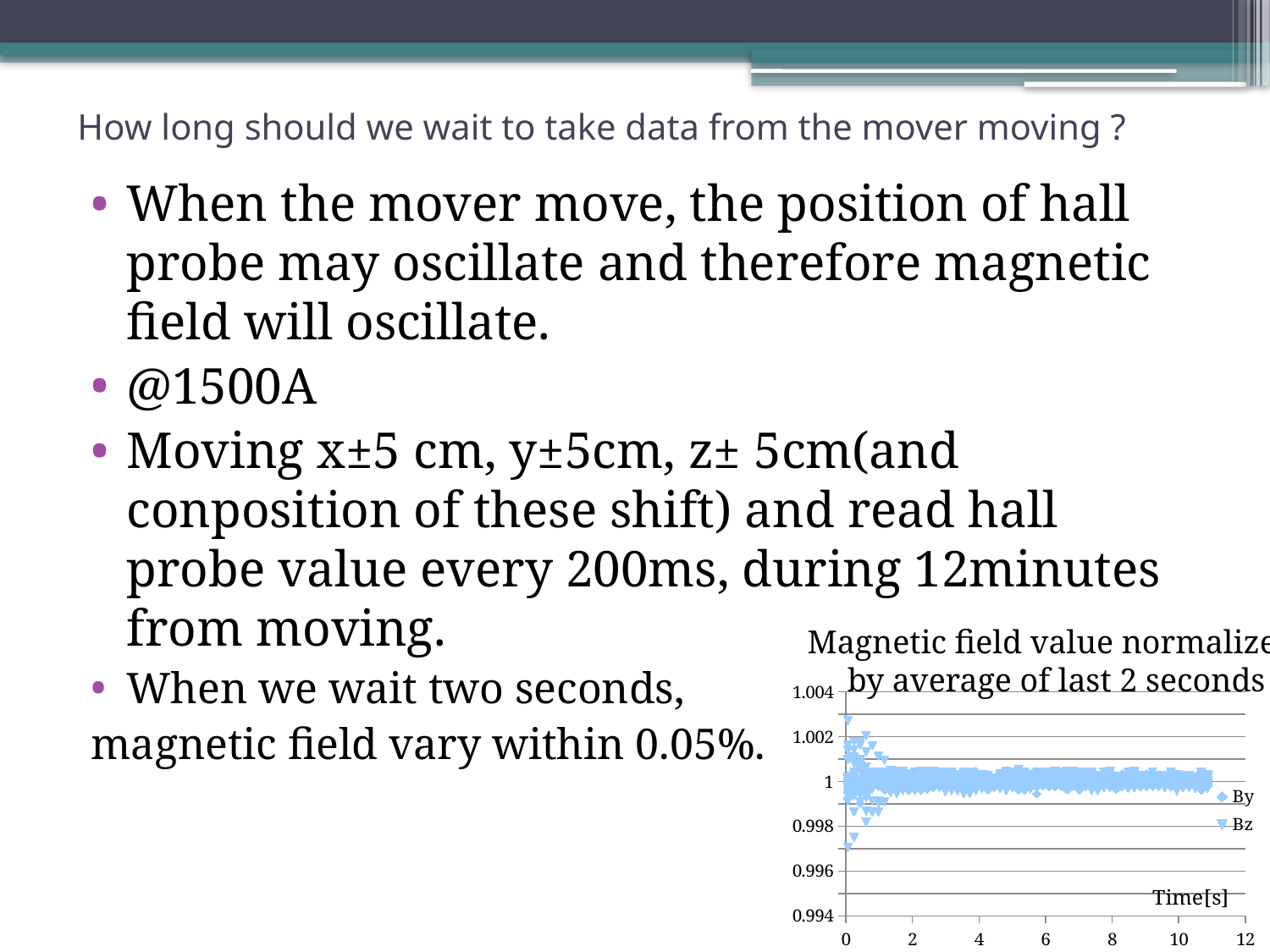
Are the plotted values after 4 seconds greater or less than 1.002? less What is the largest tick value on the chart's x axis? 12 What are the two series named in the chart's legend? By and Bz Which series in the legend is drawn with triangle markers? Bz How many series does the chart's legend list? 2 What kind of chart is shown on the slide? scatter chart Around which y-axis value do the plotted points settle after the first few seconds? 1 Does the spread of the plotted values increase or decrease as time increases along the x axis? decrease Are the plotted values after 4 seconds greater or less than 0.998? greater